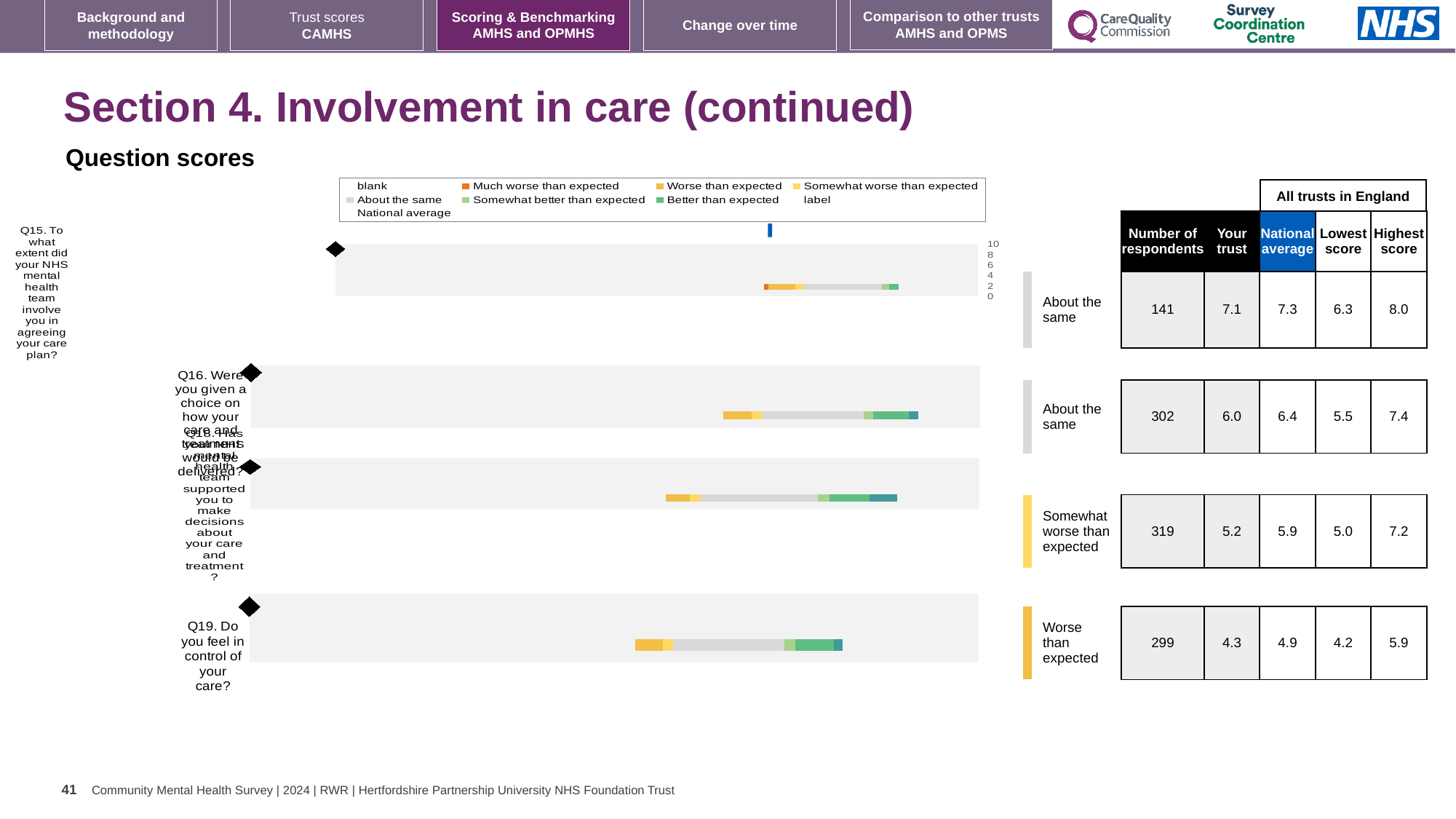
Which question has the highest 'Your trust' score? Q15 What is the national average score for Q16 (Were you given a choice on how your care and treatment would be delivered?)? 6.4 For Q16, which is larger: the 'Your trust' score or the national average? National average How many respondents answered Q18 (Has your NHS mental health team supported you to make decisions about your care and treatment?)? 319 What is the 'Your trust' score for Q19 (Do you feel in control of your care?)? 4.3 What is the difference between the highest score (8.0) and the lowest score (6.3) across all trusts for Q15? 1.7 What benchmark category is shown for Q19 (Do you feel in control of your care?)? Worse than expected What kind of chart is used to show the question scores on this slide? bar chart Which question has the lowest 'Your trust' score? Q19 What is the lowest score across all trusts in England for Q18? 5.0 What is the difference between the national average (4.9) and the 'Your trust' score (4.3) for Q19? 0.6 How many questions (Q15, Q16, Q18, Q19) are charted on this slide? 4